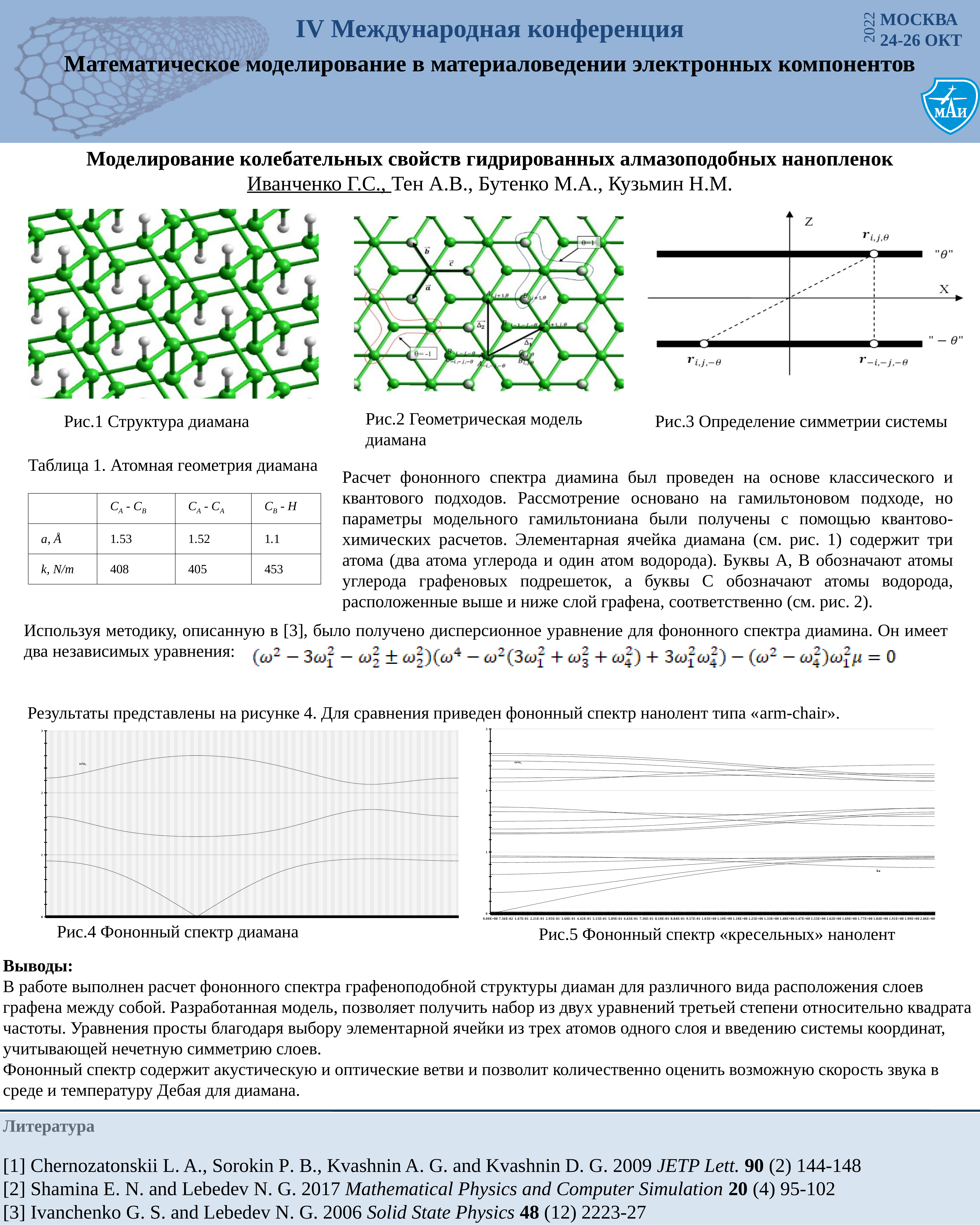
In Рис.4 Фононный спектр диамана, is the topmost curve greater or less than 2 across the whole horizontal range? greater In Рис.4 Фононный спектр диамана, is the bottom curve at the left edge of the chart greater or less than 1? less In Рис.4 Фононный спектр диамана, what is the highest tick value shown on the vertical axis? 3 In Рис.5 Фононный спектр «кресельных» нанолент, is the topmost curve greater or less than 2? greater In Рис.4 Фононный спектр диамана, what is the lowest value reached by the bottom curve at the centre of the horizontal axis? 0 In Рис.4 Фононный спектр диамана, does the bottom curve fall or rise from the left edge toward the centre of the horizontal axis? fall What kind of chart is Рис.4 Фононный спектр диамана? line chart What is the caption of the chart on the left of the slide? Рис.4 Фононный спектр диамана What kind of chart is Рис.5 Фононный спектр «кресельных» нанолент? line chart